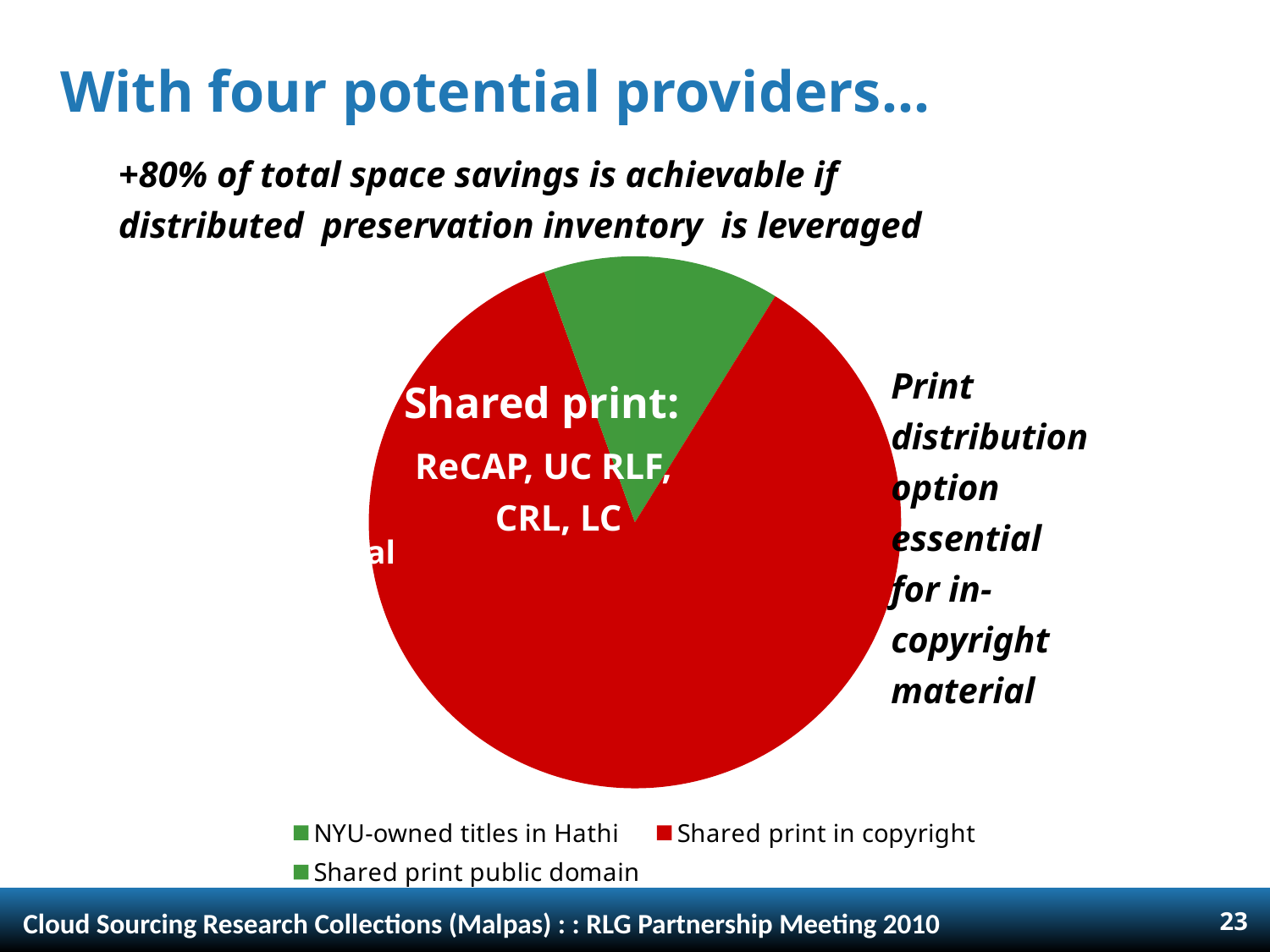
What kind of chart is shown on the slide? pie chart Which is larger in the pie chart: Shared print in copyright or NYU-owned titles in Hathi? Shared print in copyright How many entries does the legend of the pie chart list? 3 Which category takes up the largest slice of the pie chart? Shared print in copyright What colour represents Shared print in copyright in the pie chart? red What text is written over the pie chart in white? Shared print: ReCAP, UC RLF, CRL, LC